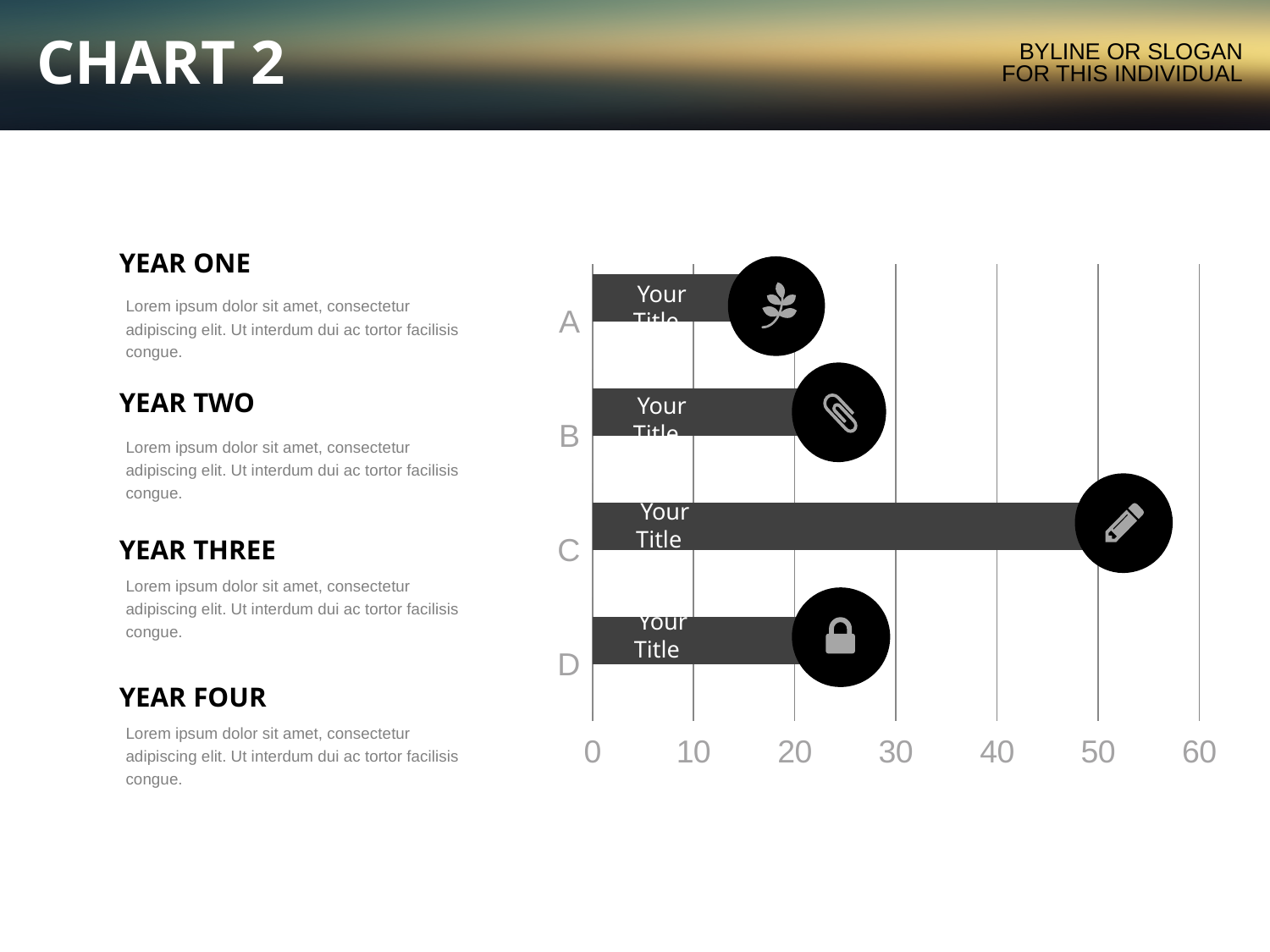
What kind of chart is shown on the slide? bar chart Is the value for A greater or less than 30? less Is the value for D greater or less than 40? less Which is larger, the value for C or the value for A? C Which is larger, the value for B or the value for C? C Which category has the highest value on the chart? C How many categories are plotted on the chart? 4 Is the value for C greater or less than 40? greater What is the highest value shown on the horizontal axis? 60 What text label appears on each bar of the chart? Your Title